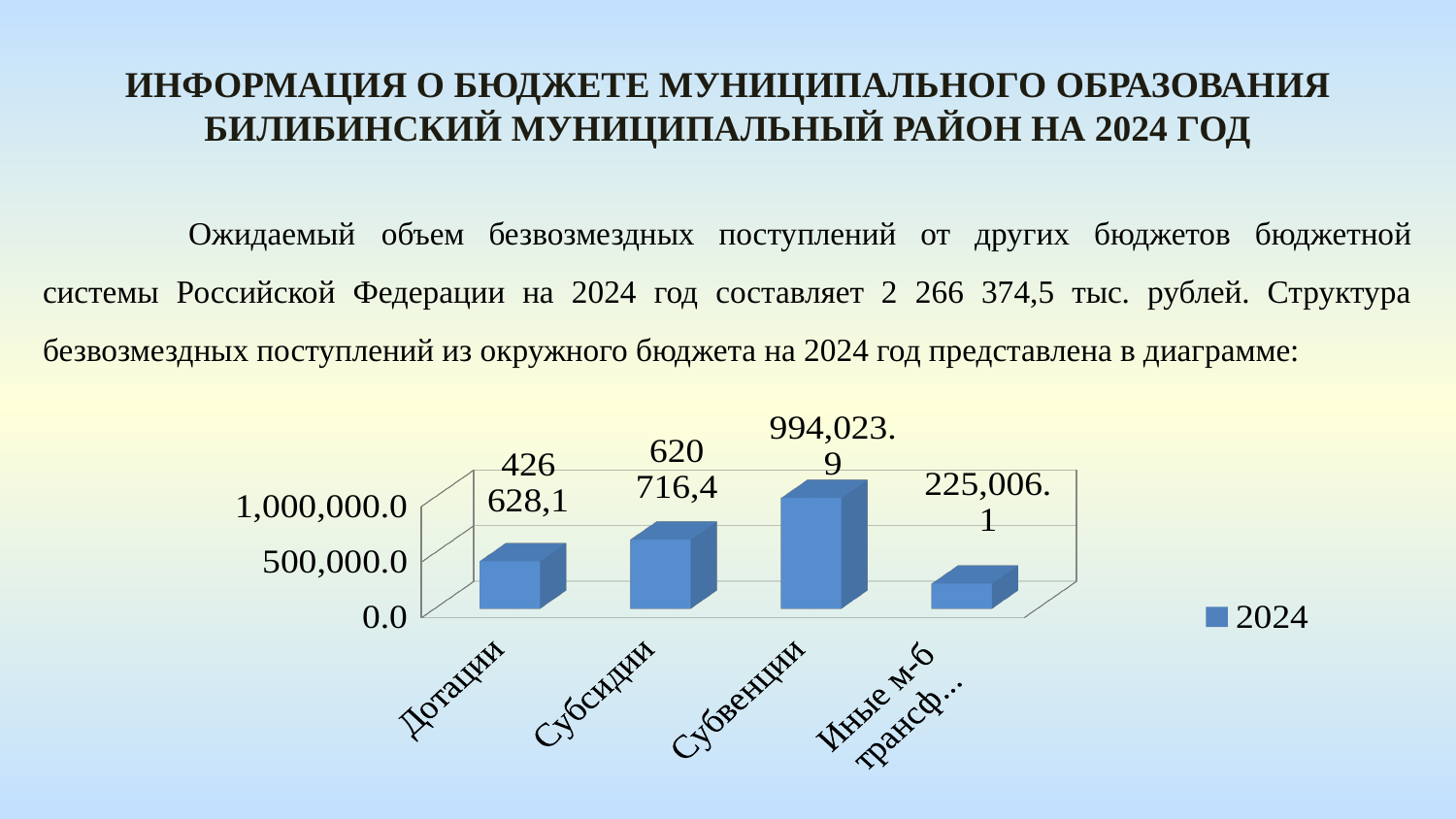
Which category has the lowest value in the chart? Иные м-б трансф... How many categories are shown in the chart? 4 What is the value for Субсидии in the chart? 620 716,4 What is the difference between the values for Субвенции and Субсидии? 373,307.5 Which category has the highest value in the chart? Субвенции What is the value shown for the fourth bar (Иные м-б трансф...) in the chart? 225,006.1 How many series does the legend list? 1 Is the value for Субвенции greater or less than 500,000.0? greater What kind of chart is shown on the slide? bar chart What is the value for Дотации in the chart? 426 628,1 Which is larger, the value for Дотации or the value for Субсидии? Субсидии What is the value for Субвенции in the chart? 994,023.9